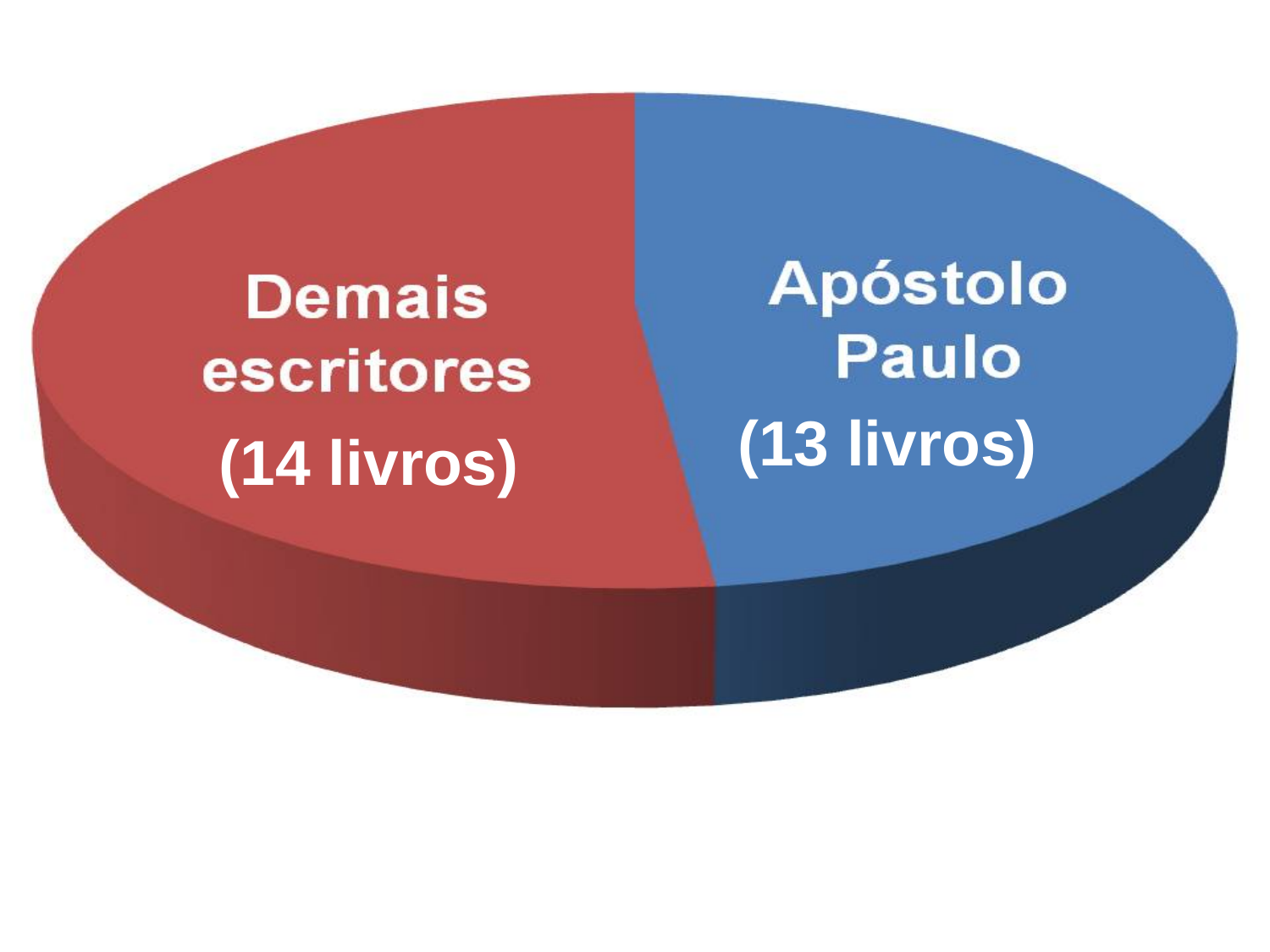
Which has more books, Apóstolo Paulo or Demais escritores? Demais escritores How many books are attributed to Demais escritores in the pie chart? 14 livros What is the total number of books represented by both slices of the pie chart? 27 livros Which slice of the pie chart represents the smaller number of books? Apóstolo Paulo What colour is the slice for Demais escritores? Red Which slice of the pie chart represents the larger number of books? Demais escritores What kind of chart is shown on the slide? Pie chart What is the difference in the number of books between Demais escritores and Apóstolo Paulo? 1 livro How many books are attributed to Apóstolo Paulo in the pie chart? 13 livros How many slices does the pie chart have? 2 What colour is the slice for Apóstolo Paulo? Blue